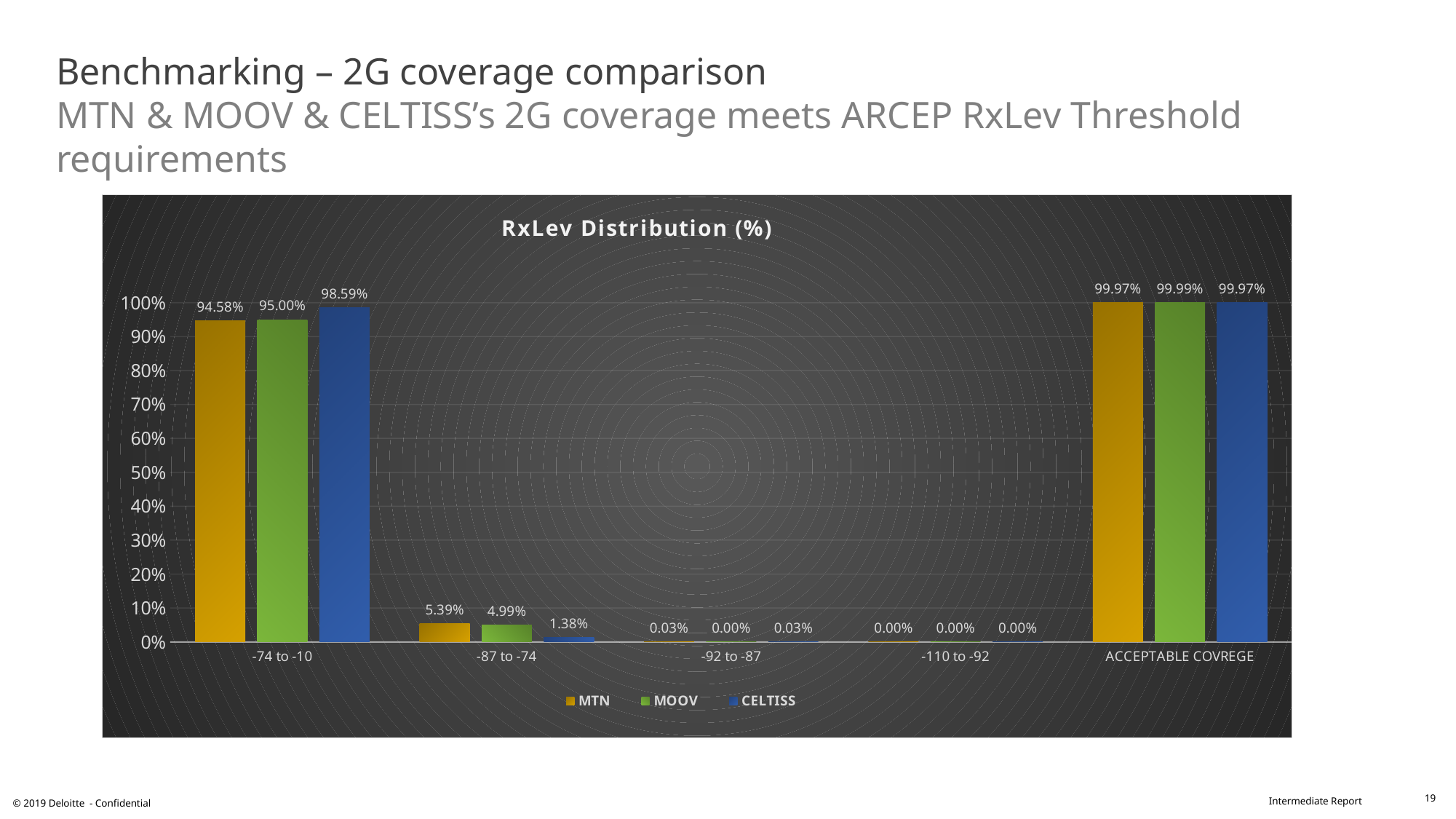
Which series has the lowest value in the -87 to -74 category? CELTISS Which colour represents MOOV in the chart? green What is the difference between the MTN and MOOV values in the -87 to -74 category? 0.40% What is the MOOV value for the ACCEPTABLE COVREGE category? 99.99% Which series has the highest value in the -74 to -10 category? CELTISS What is the CELTISS value for the -87 to -74 category? 1.38% What is the title of the chart? RxLev Distribution (%) How many categories are shown on the x axis of the chart? 5 How many series does the chart legend list? 3 What is the MTN value for the -74 to -10 category? 94.58% Which is larger in the -74 to -10 category, the MTN value or the CELTISS value? CELTISS What kind of chart is shown on the slide? bar chart